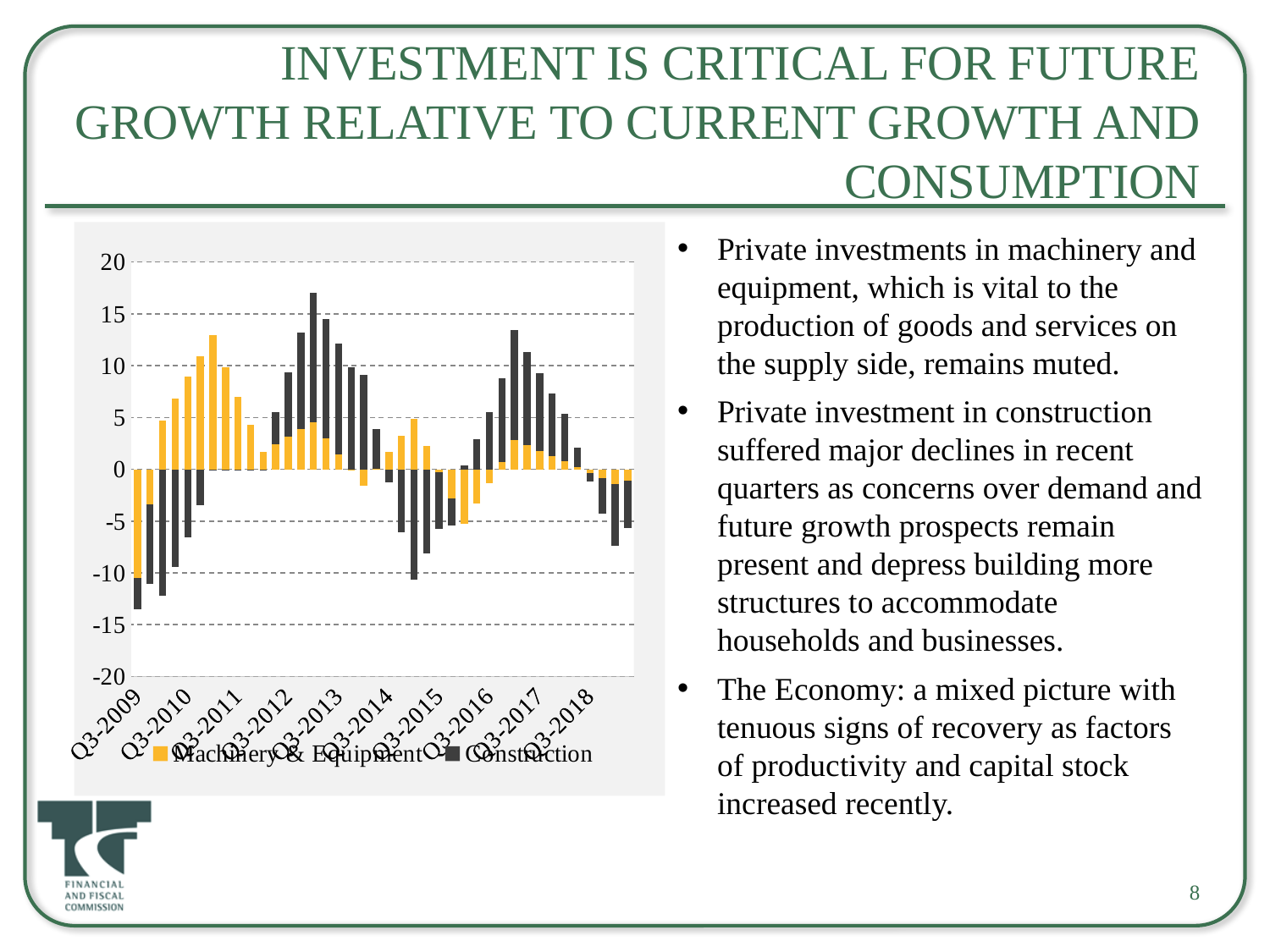
Which colour represents the Construction series in the chart? dark grey Is the Machinery & Equipment value for Q3-2009 greater or less than -5? less Do the Machinery & Equipment values rise or fall between Q3-2009 and Q3-2010? rise Is the highest point reached by the Machinery & Equipment bars greater or less than 10? greater What are the two series named in the chart legend? Machinery & Equipment and Construction How many series does the chart legend list? 2 What is the highest value shown on the chart's y axis? 20 What is the lowest value shown on the chart's y axis? -20 How many labelled categories appear on the x axis of the chart? 10 What kind of chart is shown on the slide? bar chart